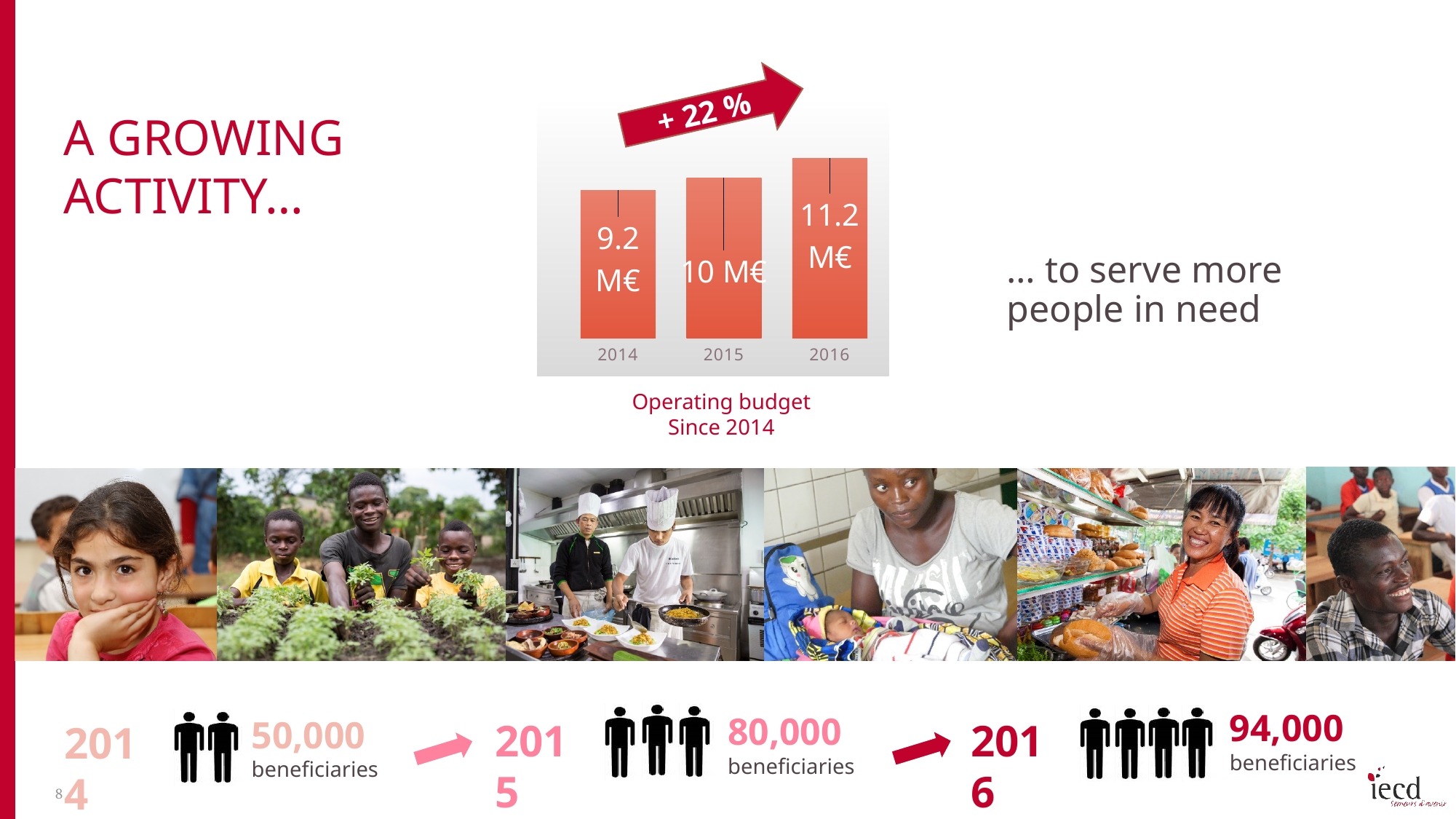
Which is larger, the operating budget in 2015 or in 2016? 2016 Which year has the lowest operating budget? 2014 Does the operating budget rise or fall from 2014 to 2016? Rise Which year has the highest operating budget? 2016 What was the operating budget in 2014? 9.2 M€ How many years are shown in the operating budget chart? 3 What percentage growth is shown by the arrow above the operating budget chart? + 22 % What was the operating budget in 2016? 11.2 M€ What kind of chart shows the operating budget? Bar chart What is the difference between the operating budget in 2015 and in 2014? 0.8 M€ What was the operating budget in 2015? 10 M€ What is the difference between the operating budget in 2016 and in 2014? 2 M€